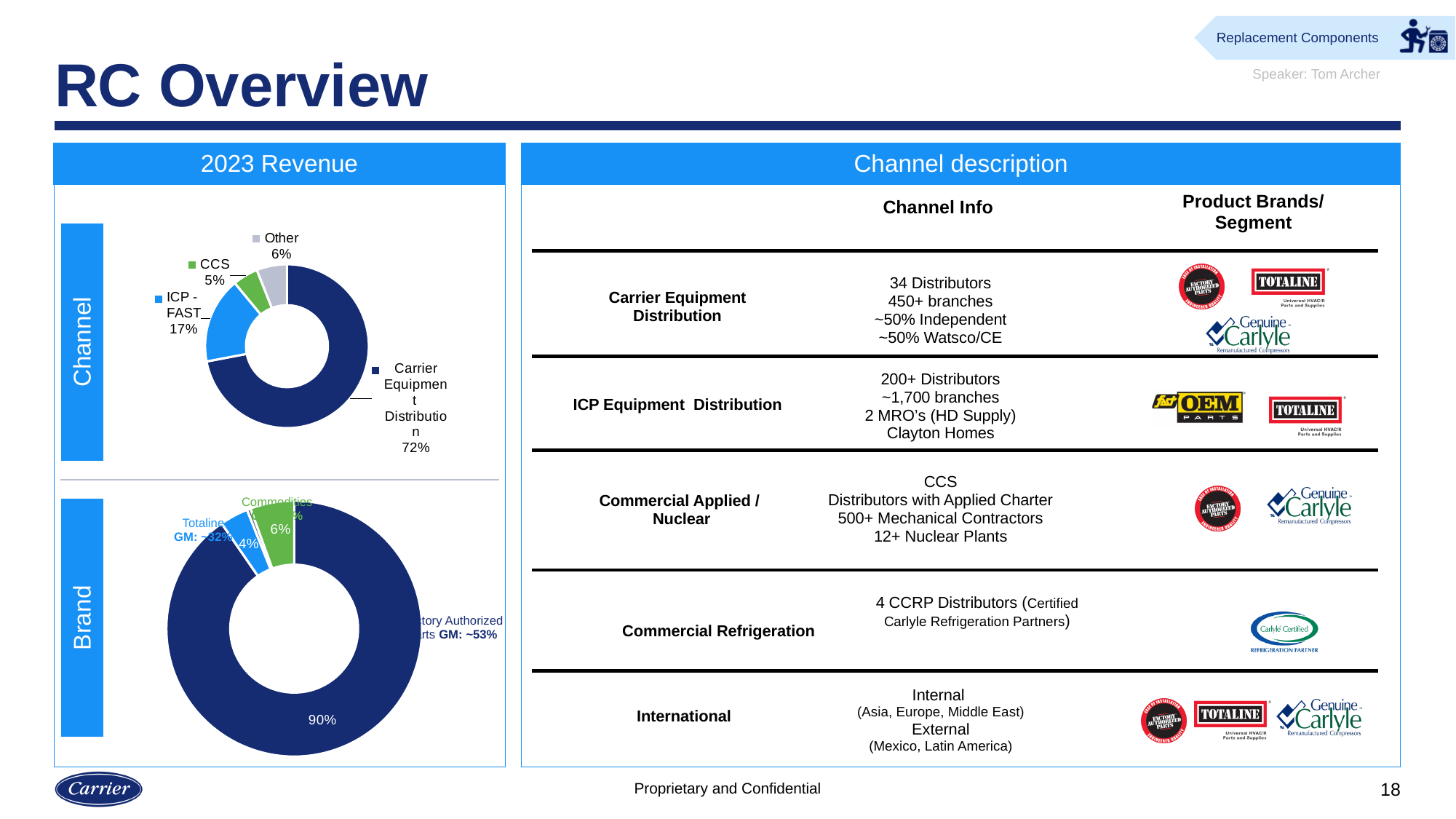
In the Brand donut chart, what share of revenue is Commodities? 6% How many categories are shown in the Channel donut chart? 4 In the Channel donut chart under 2023 Revenue, what share of revenue is Carrier Equipment Distribution? 72% In the Brand donut chart, what share of revenue is Totaline? 4% In the Channel donut chart, which channel has the largest share of revenue? Carrier Equipment Distribution In the Channel donut chart, what share of revenue is CCS? 5% In the Channel donut chart, what share of revenue is ICP - FAST? 17% In the Channel donut chart, which is larger, Other or CCS? Other What kind of chart is used for the Channel breakdown of 2023 Revenue? Donut (pie) chart In the Channel donut chart, which channel has the smallest share of revenue? CCS In the Channel donut chart, how many percentage points larger is ICP - FAST than CCS? 12 percentage points In the Channel donut chart, what share of revenue is Other? 6%